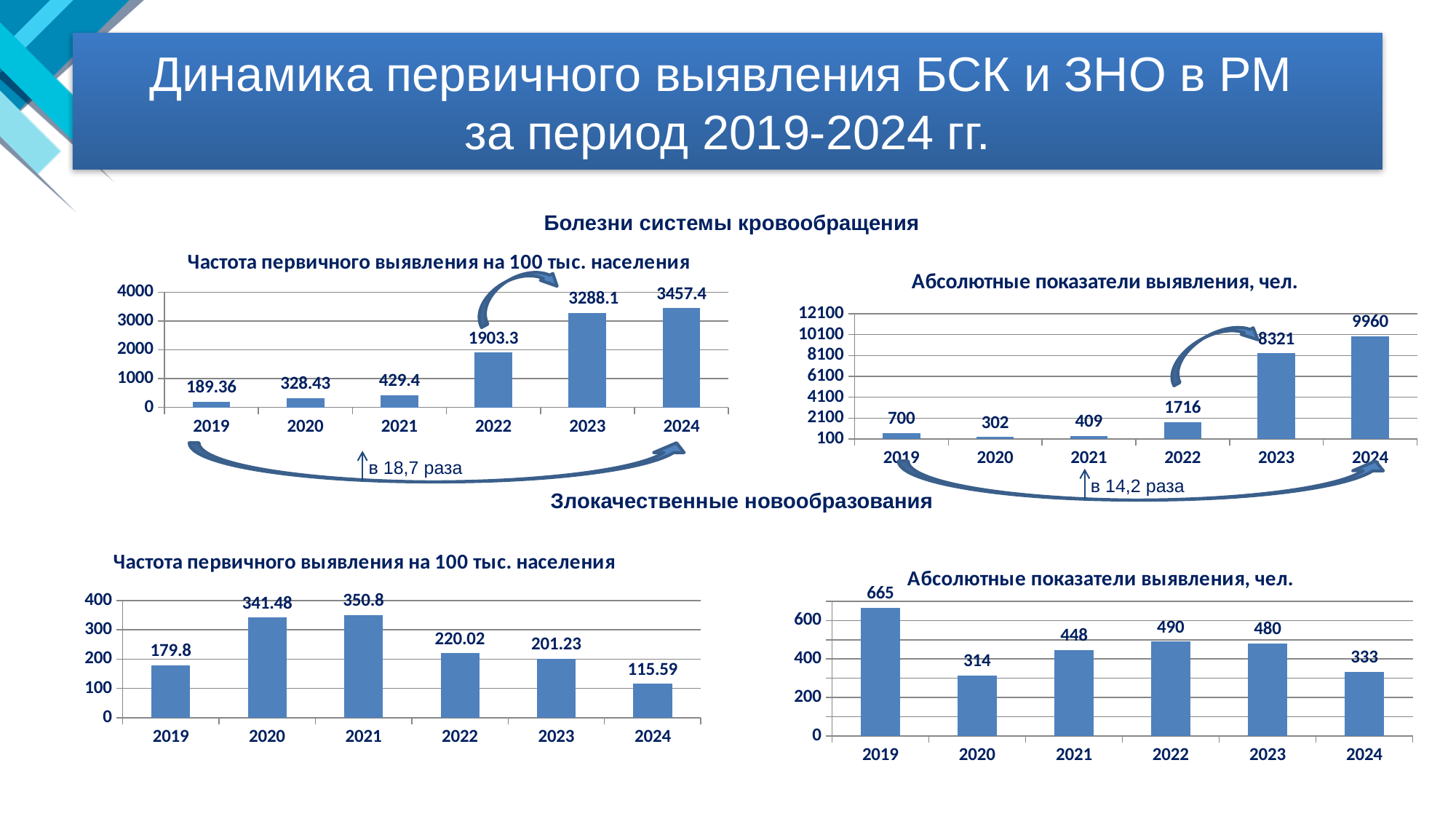
In the top-right chart (Болезни системы кровообращения, absolute numbers), which year has the lowest value? 2020 In the bottom-left chart (Злокачественные новообразования, frequency per 100 thousand), which year has the highest value? 2021 In the bottom-right chart (Злокачественные новообразования, Абсолютные показатели выявления, чел.), what is the value for 2019? 665 In the bottom-right chart (Злокачественные новообразования, absolute numbers), which year has the lowest value? 2020 How many years (categories) are shown on the x axis of the bottom-right chart (Злокачественные новообразования, absolute numbers)? 6 In the top-left chart (Болезни системы кровообращения, Частота первичного выявления на 100 тыс. населения), what is the value for 2022? 1903.3 In the top-left chart (Болезни системы кровообращения, frequency per 100 thousand), which year has the highest value? 2024 What kind of chart is the top-left chart (Болезни системы кровообращения, frequency per 100 thousand)? Bar chart In the bottom-left chart (Злокачественные новообразования, Частота первичного выявления на 100 тыс. населения), what is the value for 2024? 115.59 In the top-right chart (Болезни системы кровообращения, Абсолютные показатели выявления, чел.), what is the value for 2023? 8321 In the bottom-left chart (Злокачественные новообразования, frequency per 100 thousand), which is larger: the value for 2020 or the value for 2022? 2020 In the top-right chart (Болезни системы кровообращения, absolute numbers), what is the difference between the 2024 and 2023 values? 1639